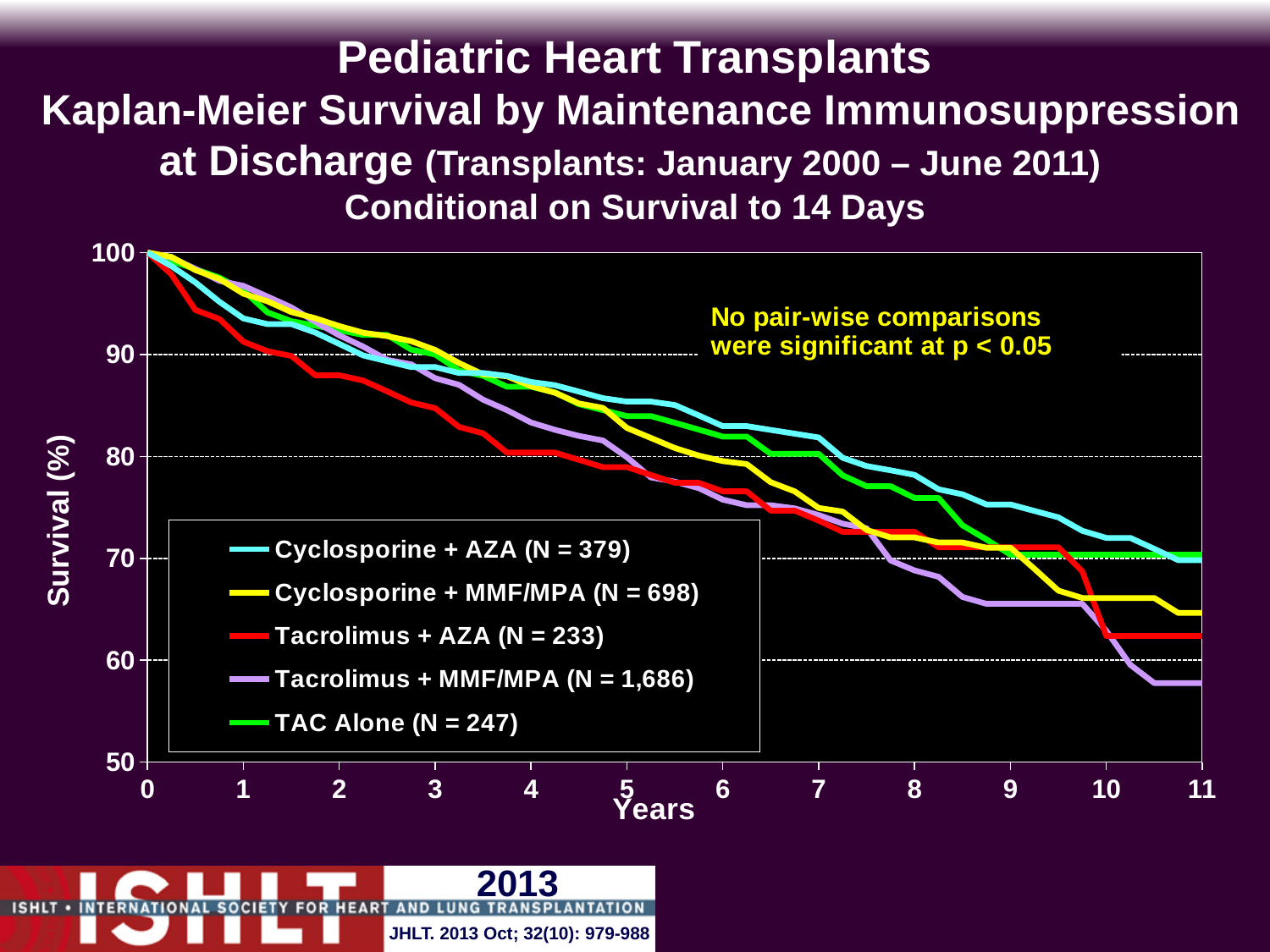
According to the legend, what is the N for the Tacrolimus + MMF/MPA group? 1,686 What kind of chart is shown on the slide? line chart Is the survival for Tacrolimus + AZA at year 11 greater or less than 60? greater At year 11, which is larger: the survival for Tacrolimus + AZA or for Tacrolimus + MMF/MPA? Tacrolimus + AZA Is the survival for Cyclosporine + AZA at year 5 greater or less than 80? greater How many series does the legend list? 5 Is the survival for Tacrolimus + AZA at year 2 greater or less than 90? less What is the survival (%) for all groups at year 0? 100 Do the survival curves rise or fall as years increase along the x axis? fall What does the annotation on the chart say about pair-wise comparisons? No pair-wise comparisons were significant at p < 0.05 Which group has the lowest survival at year 11? Tacrolimus + MMF/MPA